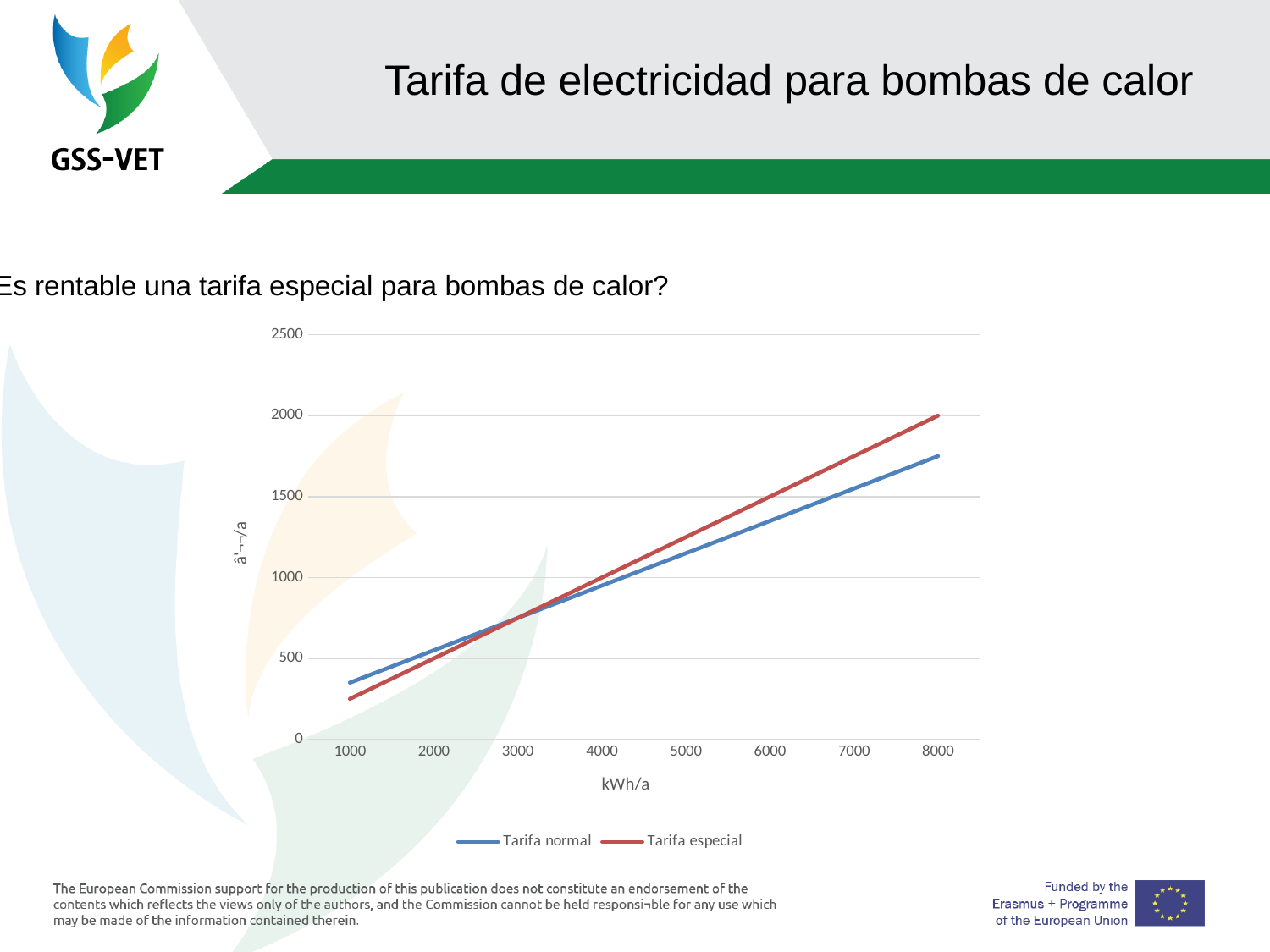
What are the two series named in the legend? Tarifa normal and Tarifa especial At 1000 kWh/a, which series has the higher value, Tarifa normal or Tarifa especial? Tarifa normal What is the label of the x axis? kWh/a How many series does the legend list? 2 How many tick values are shown along the x axis? 8 Do the values of Tarifa normal rise or fall as kWh/a increases? rise Is the value for Tarifa especial at 1000 kWh/a greater or less than 500? less Is the value for Tarifa normal at 8000 kWh/a greater or less than 1500? greater Do the values of Tarifa especial rise or fall as kWh/a increases? rise Is the value for Tarifa especial at 8000 kWh/a greater or less than 1500? greater At 8000 kWh/a, which series has the higher value, Tarifa normal or Tarifa especial? Tarifa especial What kind of chart is shown on the slide? line chart